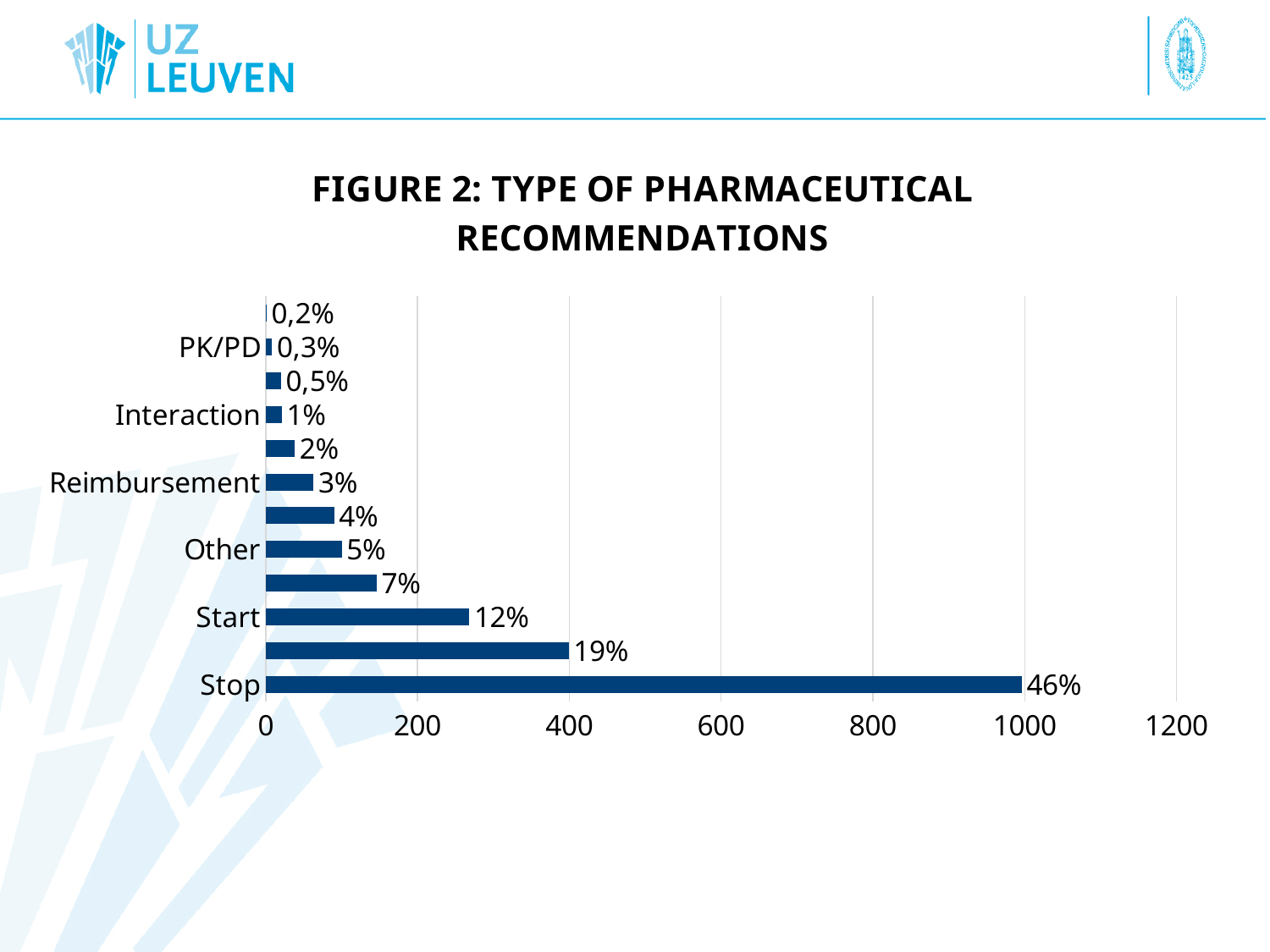
Is the bar for Stop greater or less than 800 on the x axis? greater What is the data label on the smallest bar in the chart? 0,2% What is the title of the chart? FIGURE 2: TYPE OF PHARMACEUTICAL RECOMMENDATIONS What is the data label for Other? 5% What type of chart is shown on the slide? bar chart What is the data label for PK/PD? 0,3% What is the data label for Interaction? 1% What is the data label for Reimbursement? 3% How many bars are plotted in the chart? 12 What is the data label for Stop? 46% Which category has the highest value? Stop What is the data label for Start? 12%